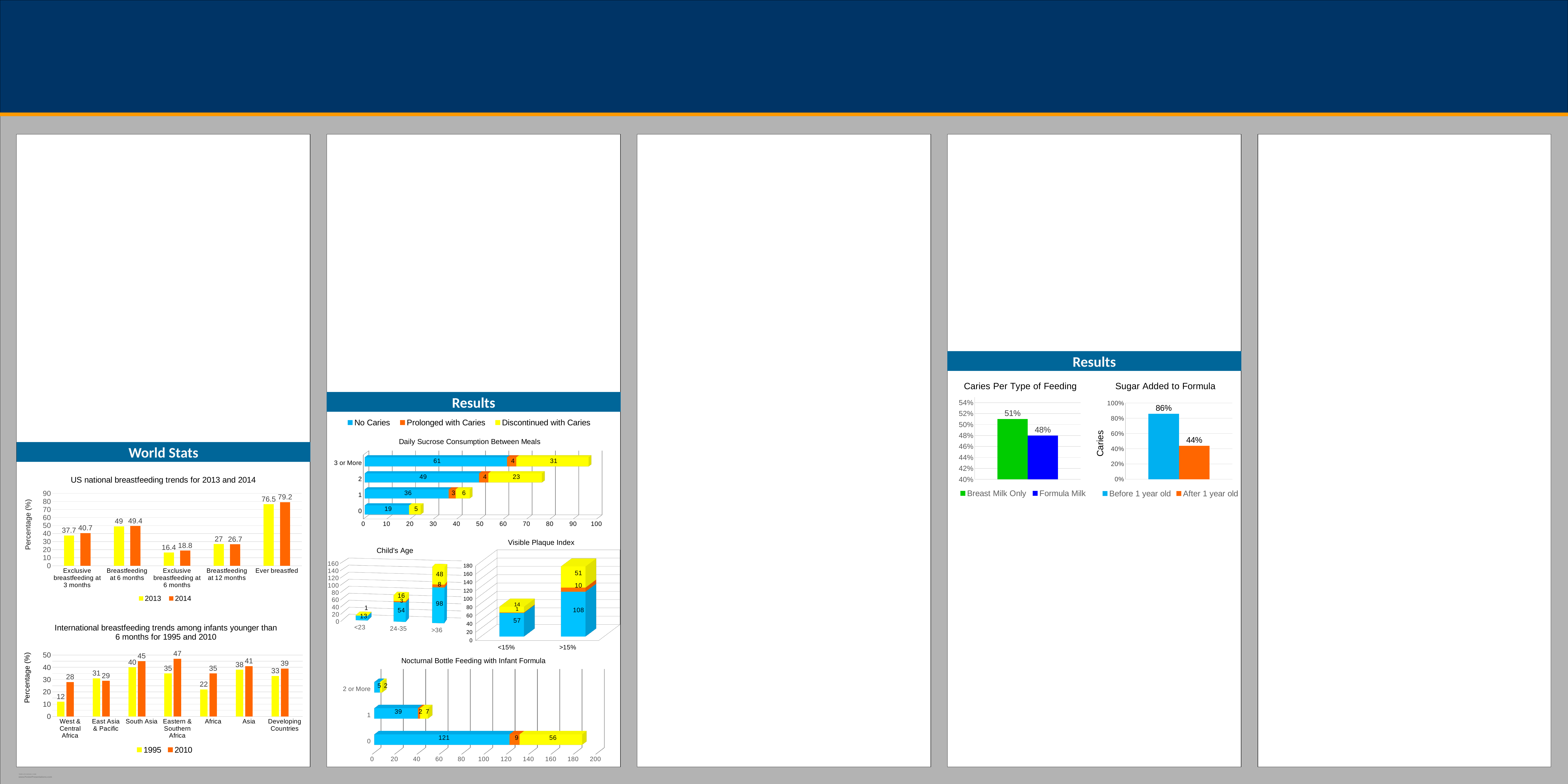
In the 'Caries Per Type of Feeding' chart, which is larger, Breast Milk Only or Formula Milk? Breast Milk Only In the 'Sugar Added to Formula' chart, what is the value for 'Before 1 year old'? 86% In the 'US national breastfeeding trends for 2013 and 2014' chart, what is the 2014 value for 'Ever breastfed'? 79.2 In the 'US national breastfeeding trends for 2013 and 2014' chart, which category has the lowest 2013 value? Exclusive breastfeeding at 6 months How many categories are shown in the 'International breastfeeding trends among infants younger than 6 months for 1995 and 2010' chart? 7 In the 'International breastfeeding trends among infants younger than 6 months for 1995 and 2010' chart, what is the difference between the 2010 and 1995 values for West & Central Africa? 16 In the 'Daily Sucrose Consumption Between Meals' chart, what is the total of the stacked bar for the '2' category? 76 In the 'Nocturnal Bottle Feeding with Infant Formula' chart, what is the total of the stacked bar for the '0' category? 186 In the 'International breastfeeding trends among infants younger than 6 months for 1995 and 2010' chart, what is the 2010 value for Eastern & Southern Africa? 47 In the 'Visible Plaque Index' chart, what is the 'Discontinued with Caries' value for the '>15%' category? 51 In the 'Child's Age' chart, what is the 'No Caries' value for the '>36' category? 98 In the 'Daily Sucrose Consumption Between Meals' chart, what is the 'No Caries' value for the '3 or More' category? 61